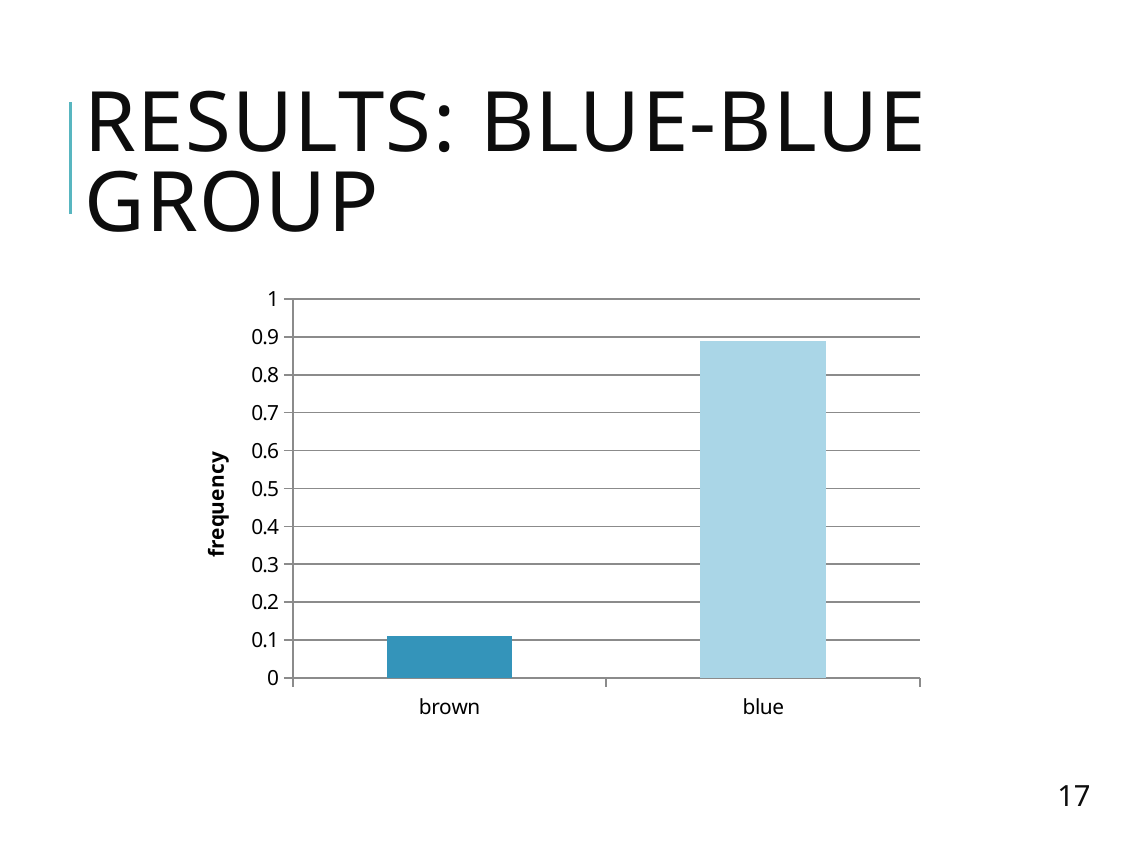
How many categories are shown on the x axis? 2 What is the maximum value shown on the y axis? 1 What is the title of the slide containing the chart? RESULTS: BLUE-BLUE GROUP Which has a larger frequency, brown or blue? blue Which category has the highest frequency? blue What kind of chart is shown on the slide? bar chart Which category has the lowest frequency? brown What is the label of the y axis? frequency Is the frequency for brown greater or less than 0.2? less Is the frequency for blue greater or less than 0.8? greater